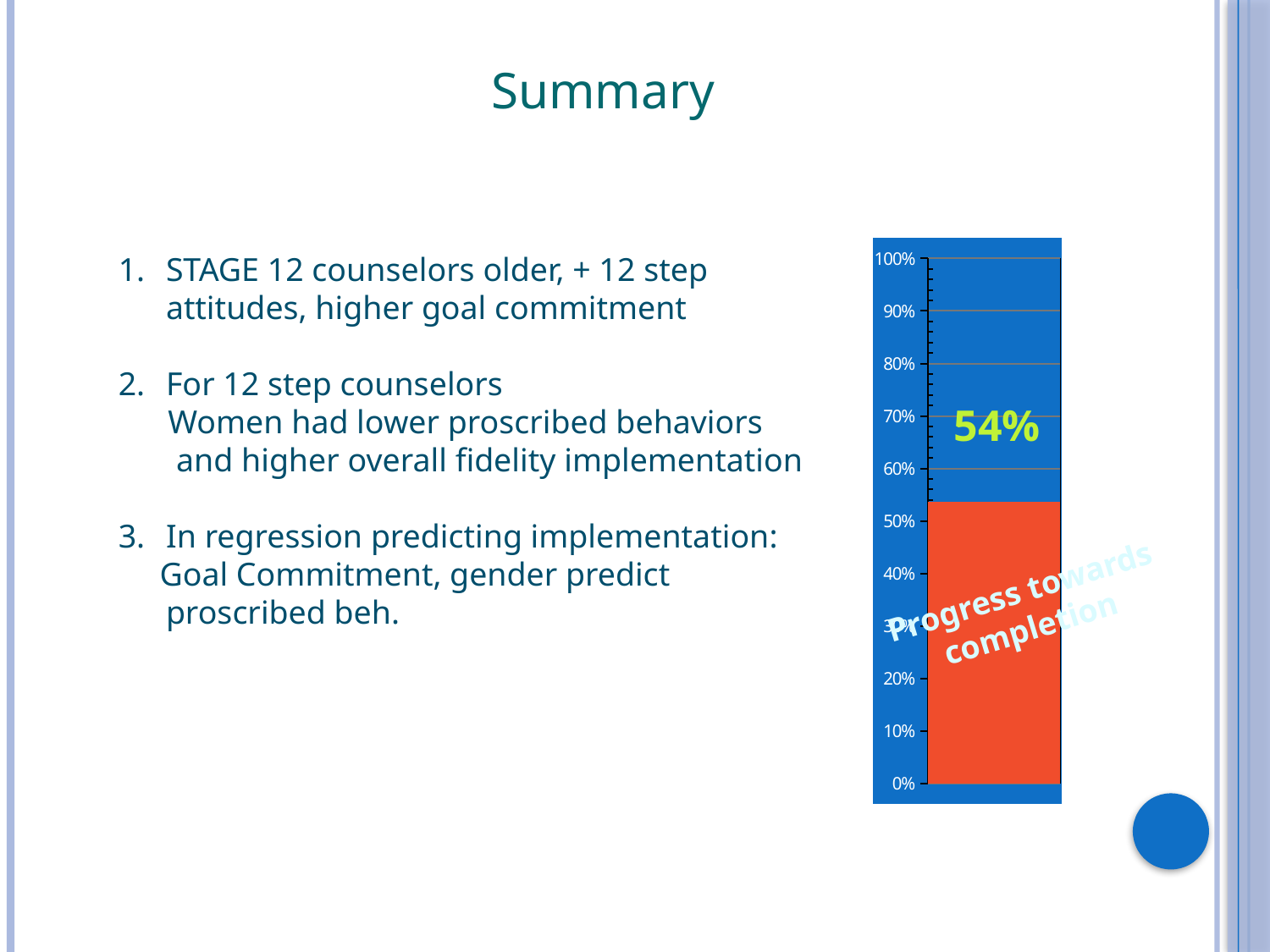
What is the highest value labelled on the chart's vertical axis? 100% What value is shown on the progress chart? 54% What kind of chart is shown on the right of the slide? bar chart How many bars are plotted on the chart? 1 Is the value shown on the progress chart greater or less than 60%? less Is the value shown on the progress chart greater or less than 50%? greater What text label is written across the chart? Progress towards completion